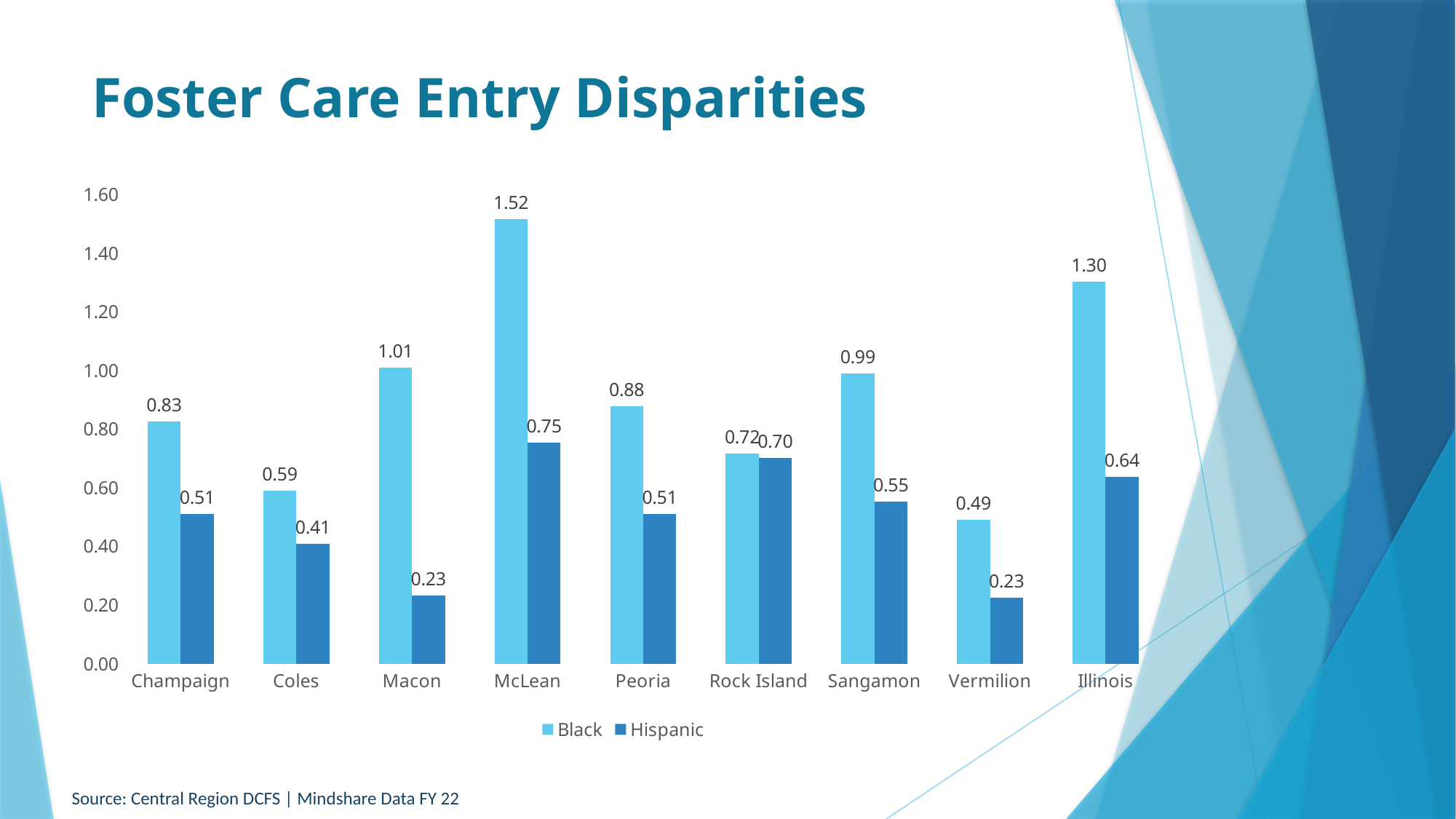
What kind of chart is shown on the slide? Bar chart What is the Hispanic value for Macon? 0.23 Which category has the lowest Black value? Vermilion What is the difference between the Black and Hispanic values for Macon? 0.78 Which series is shown in the darker blue colour? Hispanic How many series does the legend list? 2 What is the Hispanic value for Illinois? 0.64 How many categories are shown on the x axis? 9 What is the Black value for McLean? 1.52 Which is larger, the Black value for Sangamon or the Black value for Peoria? Sangamon What is the title of the slide? Foster Care Entry Disparities Which category has the highest Black value? McLean